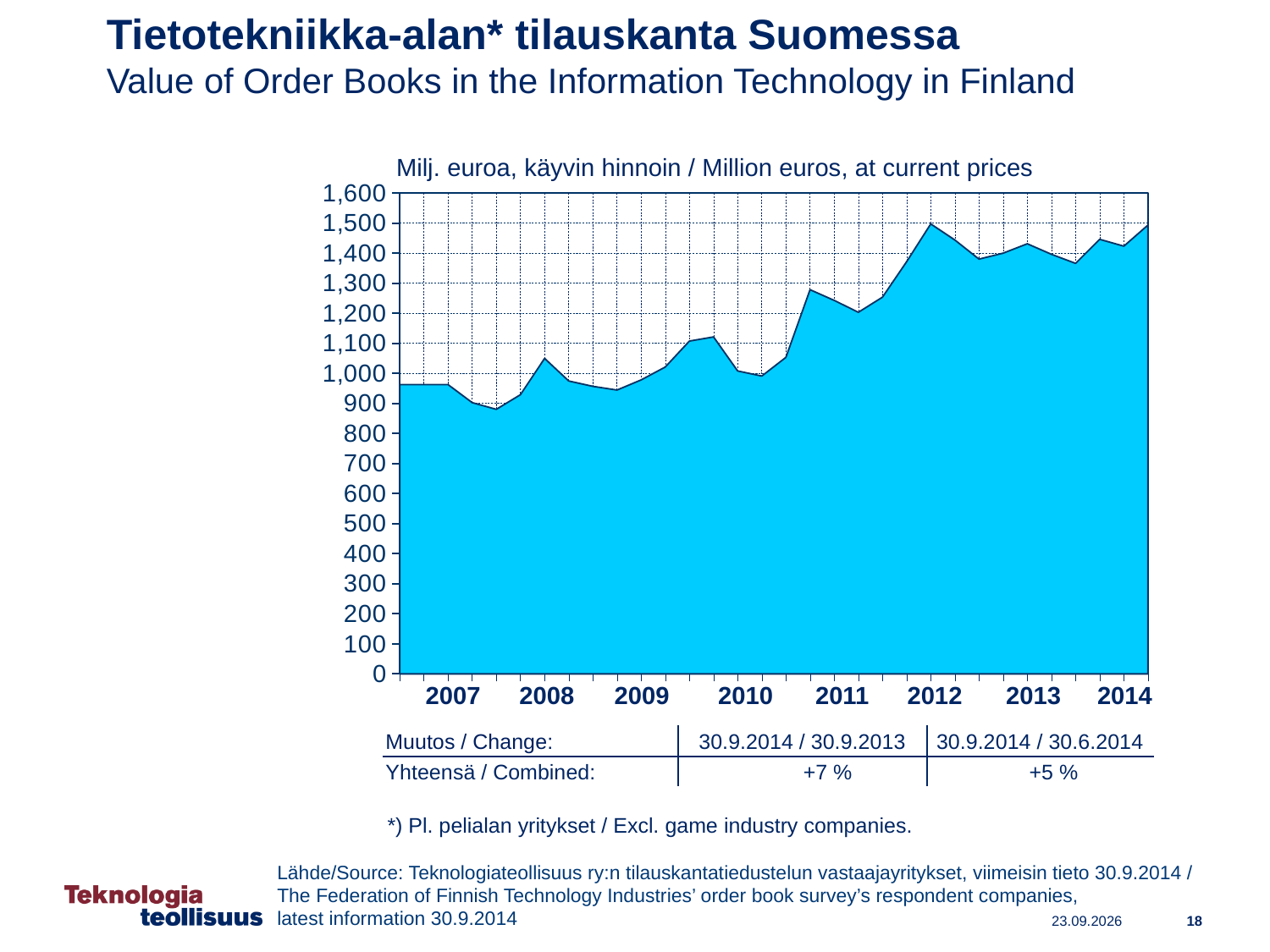
Is the value at the end of 2014 greater or less than 1,300? greater Is the value at the start of 2007 greater or less than 1,000? less Is the peak value in 2012 greater or less than 1,400? greater What kind of chart is shown on the slide? area chart What is the highest value shown on the y axis of the chart? 1,600 Which year contains the lowest point on the chart? 2007 Which is higher, the value in 2009 or the value in 2011? 2011 How many years are labelled on the x axis of the chart? 8 What unit is stated in the chart's subtitle? Milj. euroa, käyvin hinnoin / Million euros, at current prices Overall, do the values rise or fall from 2007 to 2014? rise